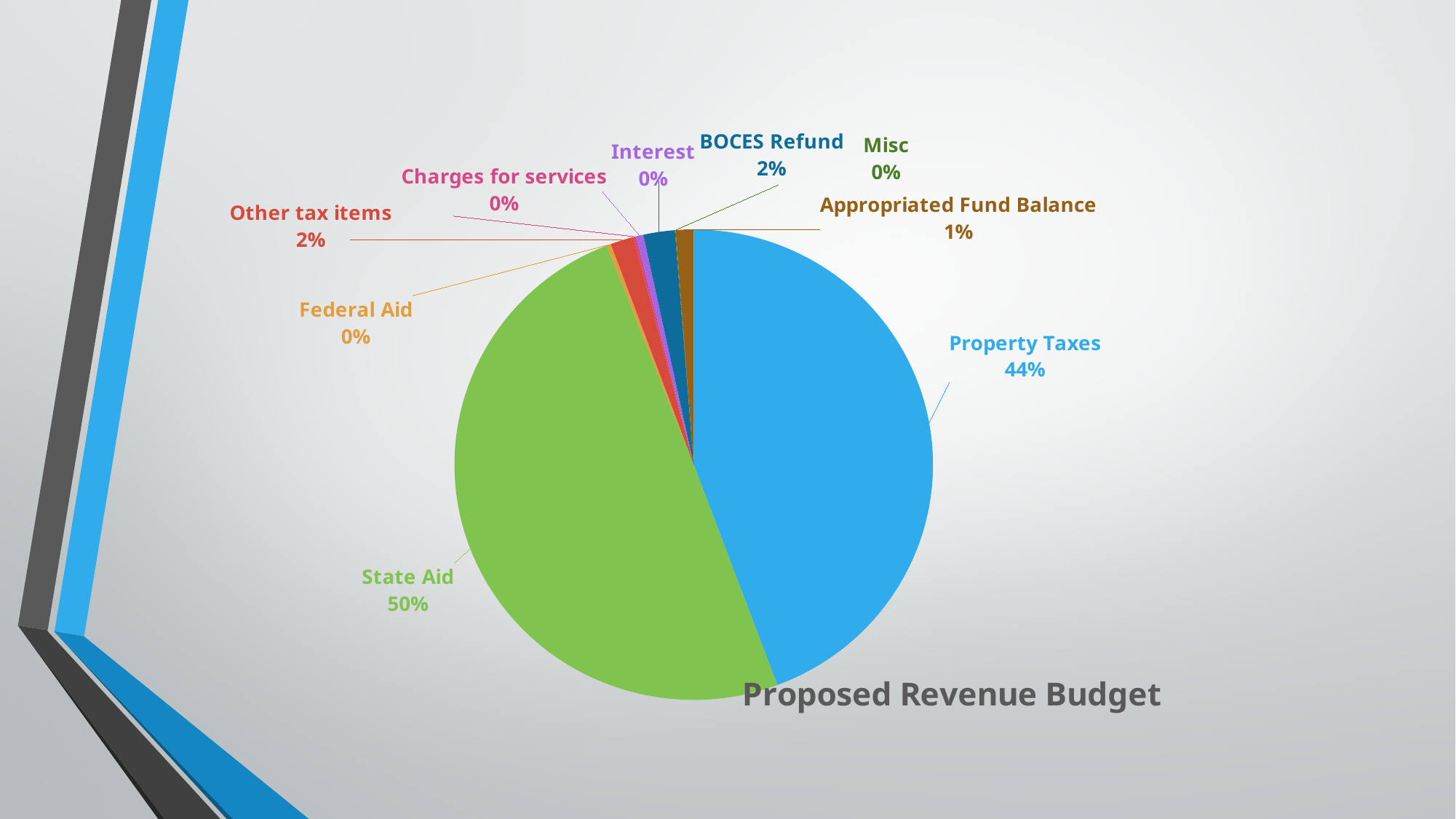
What percentage is shown for Other tax items? 2% What is the title of the chart? Proposed Revenue Budget Which is larger, State Aid or Property Taxes? State Aid Which category has the largest slice of the pie? State Aid What percentage is shown for BOCES Refund? 2% What percentage is shown for Appropriated Fund Balance? 1% How many categories are labelled on the pie chart? 9 What share of the Proposed Revenue Budget pie is State Aid? 50% What share of the Proposed Revenue Budget pie is Property Taxes? 44% What percentage is shown for Federal Aid? 0% What is the difference in percentage points between State Aid and Property Taxes? 6 What kind of chart is shown on the slide? Pie chart